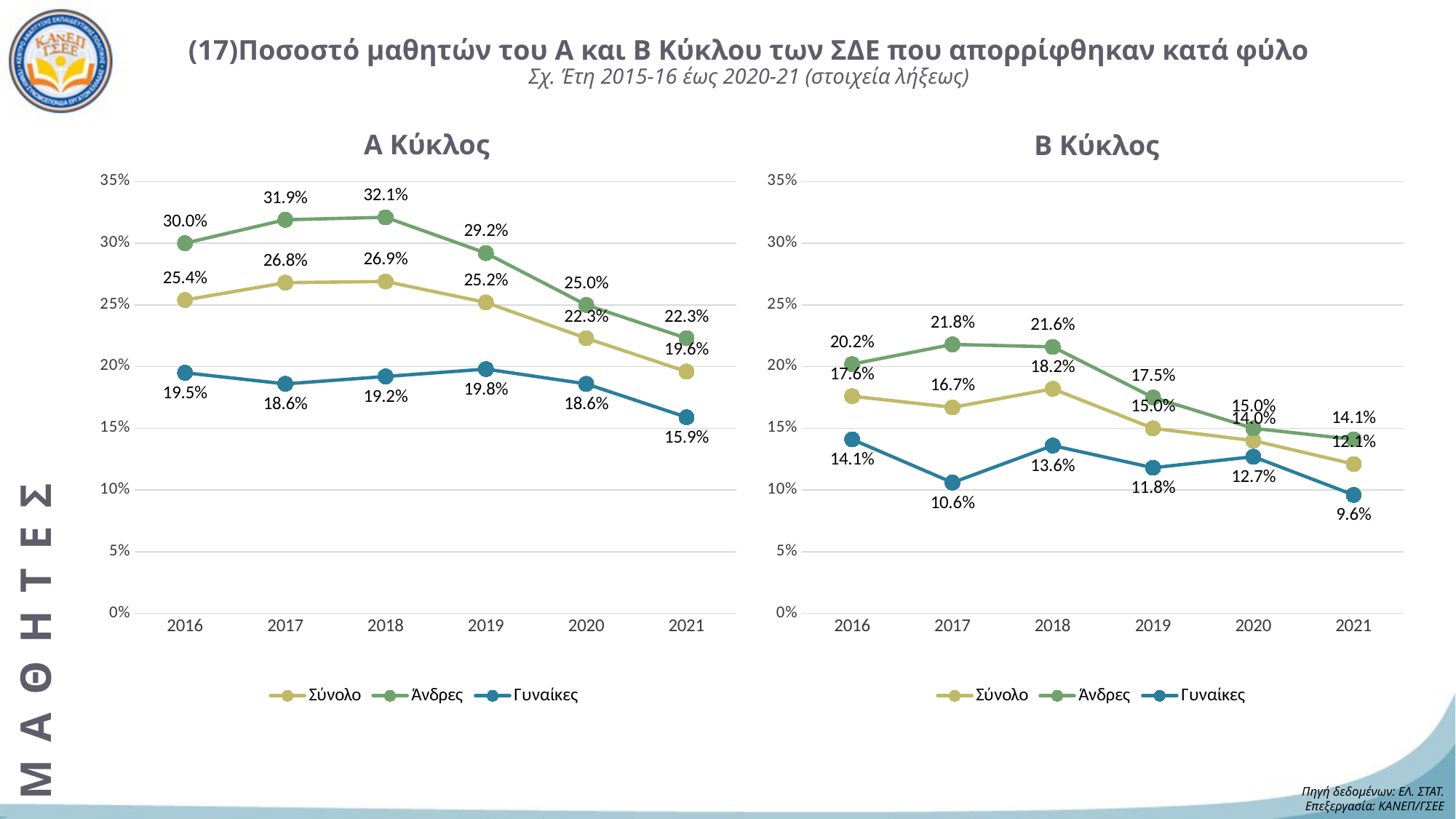
In the Β Κύκλος chart, what is the value for Γυναίκες in 2017? 10.6% How many years are shown on the x axis of the Β Κύκλος chart? 6 In the Α Κύκλος chart, in which year is the Άνδρες value highest? 2018 In the Α Κύκλος chart, does the Σύνολο value rise or fall from 2018 to 2021? Fall In the Β Κύκλος chart, in which year is the Γυναίκες value lowest? 2021 In the Α Κύκλος chart, what is the difference between the Άνδρες and Γυναίκες values in 2016? 10.5% In the Β Κύκλος chart, which is larger in 2019: the Άνδρες value or the Σύνολο value? Άνδρες In the Α Κύκλος chart, what is the value for Γυναίκες in 2021? 15.9% How many series does the legend of the Α Κύκλος chart list? 3 In the Β Κύκλος chart, what is the value for Σύνολο in 2018? 18.2% In the Α Κύκλος chart, what is the value for Άνδρες in 2018? 32.1% What kind of chart is the Α Κύκλος chart? Line chart